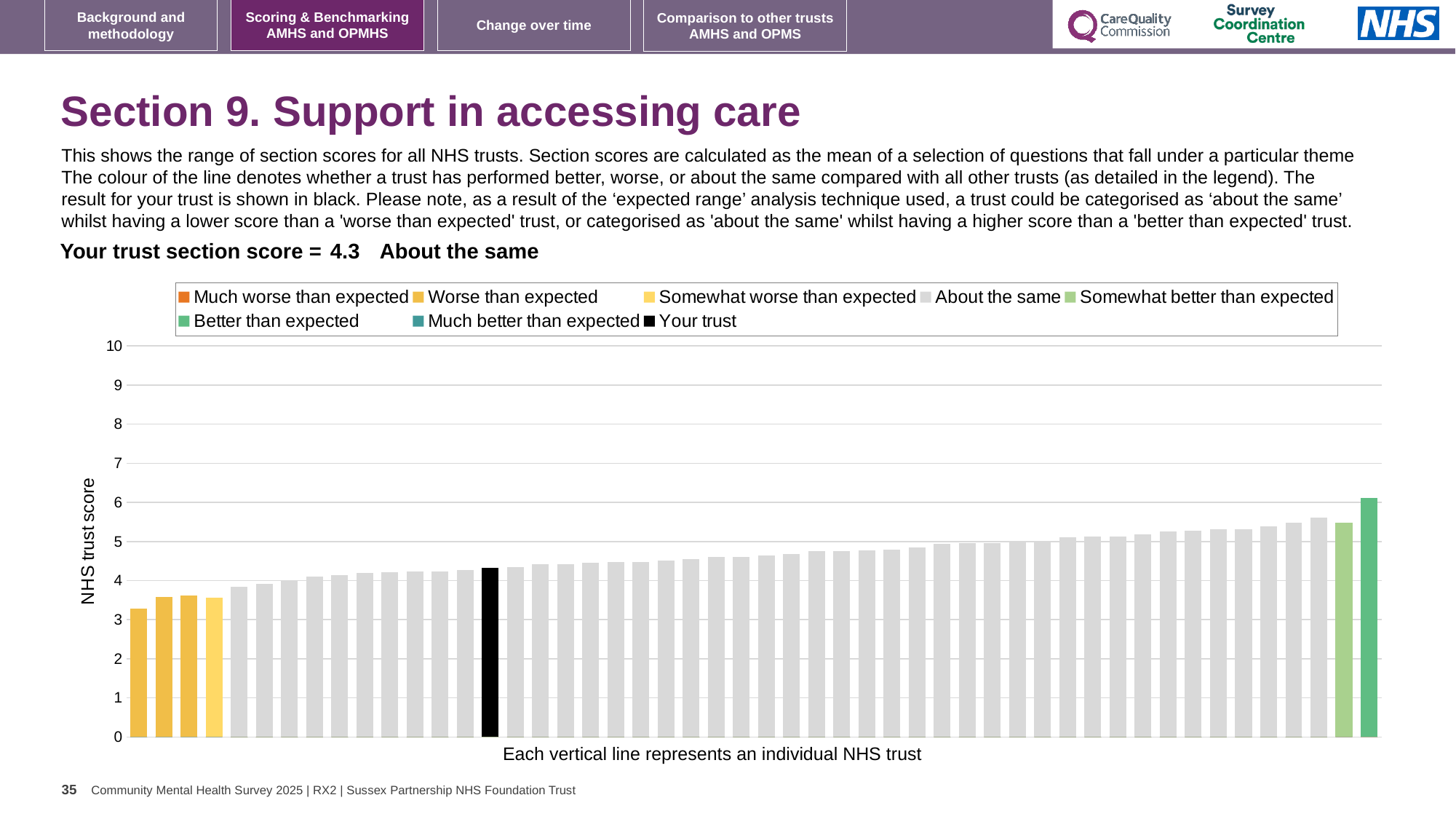
Do the bar values rise or fall from left to right along the x axis? rise Is the value of the shortest bar greater or less than 3? greater Is the value for your trust (the black bar) greater or less than 5? less What is the highest value shown on the y axis? 10 What is the label on the y axis of the chart? NHS trust score What kind of chart is shown on the slide? bar chart What is the section score for your trust shown on the slide? 4.3 Is the value of the tallest bar greater or less than 6? greater How many entries does the chart legend list? 8 What colour is the bar representing your trust? black